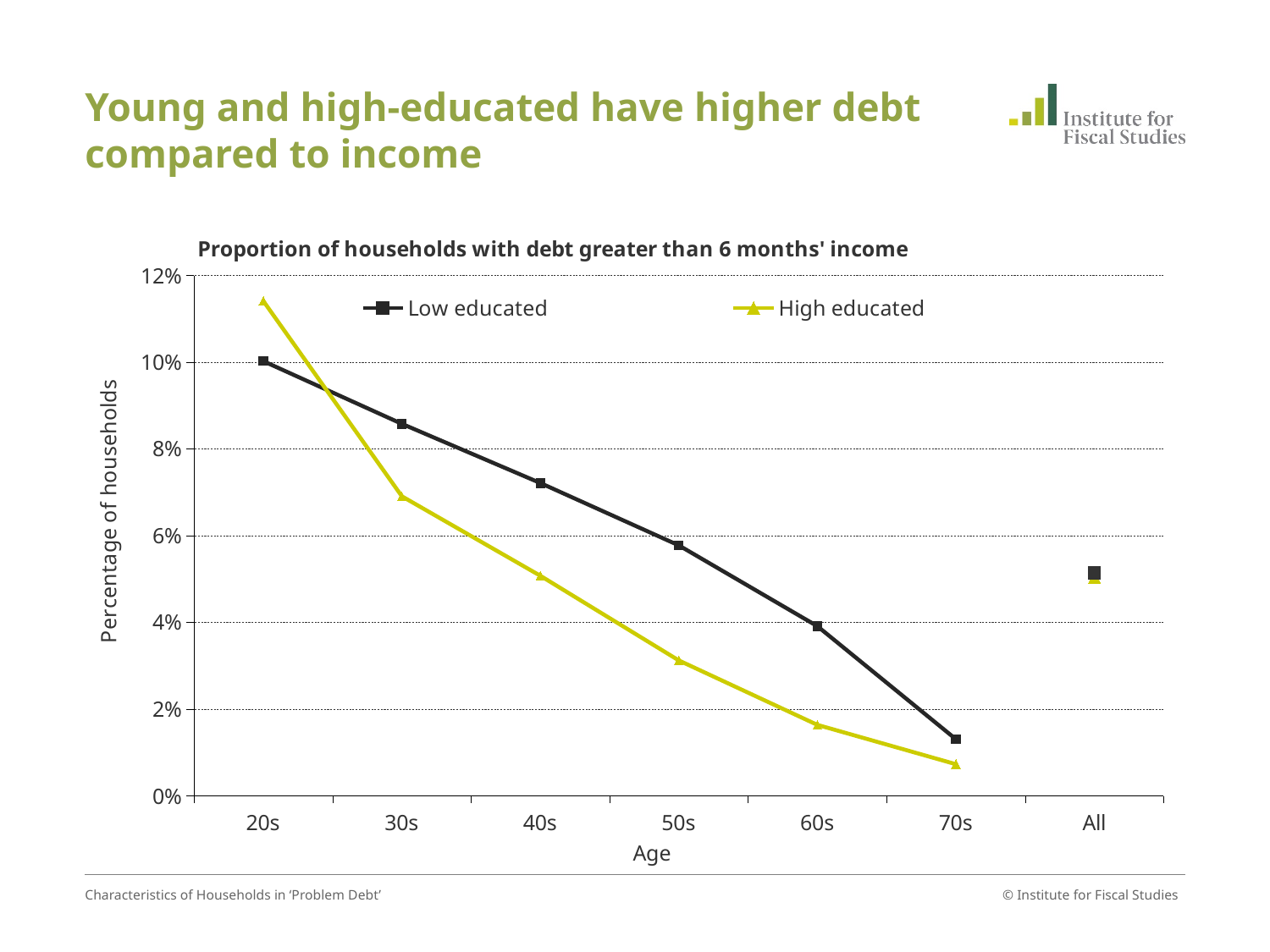
Is the Low educated value for 30s greater or less than 8%? greater Does the Low educated series rise or fall from 20s to 70s? Fall For the Low educated series, which age group has the lowest value? 70s Is the High educated value for 50s greater or less than 4%? less For the High educated series, which age group has the highest value? 20s What is the title of the chart? Proportion of households with debt greater than 6 months' income At 40s, which series has the higher value, Low educated or High educated? Low educated What kind of chart is shown on the slide? Line chart How many categories are shown along the Age axis? 7 How many series does the legend list? 2 Is the High educated value for 60s greater or less than 2%? less At 20s, which series has the higher value, Low educated or High educated? High educated